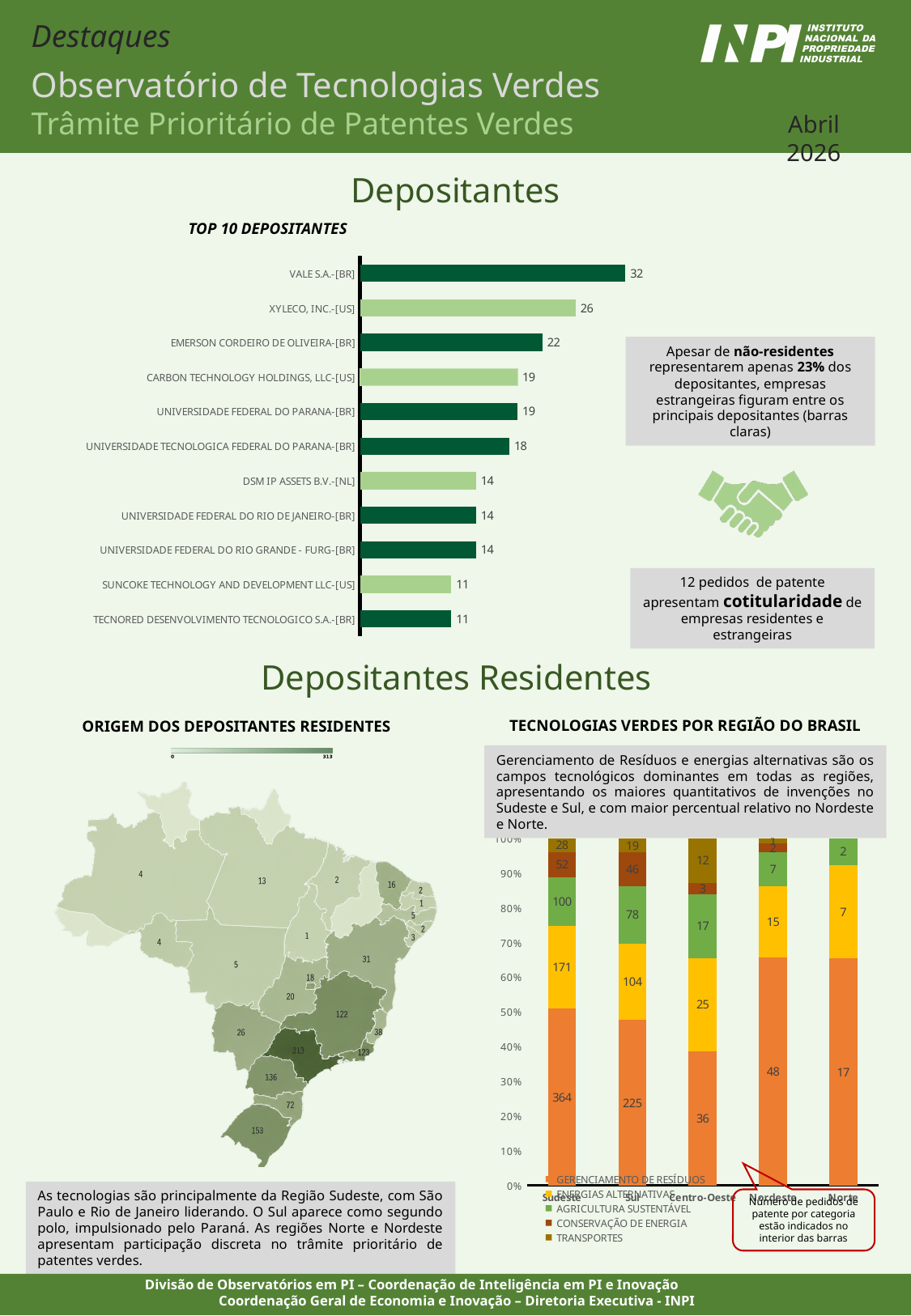
In the TOP 10 DEPOSITANTES chart, how many patent applications does VALE S.A.-[BR] have? 32 In the TOP 10 DEPOSITANTES chart, what is the difference between VALE S.A.-[BR] and EMERSON CORDEIRO DE OLIVEIRA-[BR]? 10 In the TOP 10 DEPOSITANTES chart, which is larger: UNIVERSIDADE TECNOLOGICA FEDERAL DO PARANA-[BR] or DSM IP ASSETS B.V.-[NL]? UNIVERSIDADE TECNOLOGICA FEDERAL DO PARANA-[BR] In the TECNOLOGIAS VERDES POR REGIÃO DO BRASIL chart, what is the total number of patent applications for Sudeste? 715 In the TECNOLOGIAS VERDES POR REGIÃO DO BRASIL chart, what is the value for ENERGIAS ALTERNATIVAS in Sul? 104 In the TECNOLOGIAS VERDES POR REGIÃO DO BRASIL chart, what is the value for GERENCIAMENTO DE RESÍDUOS in Sudeste? 364 In the TECNOLOGIAS VERDES POR REGIÃO DO BRASIL chart, what is the difference between GERENCIAMENTO DE RESÍDUOS in Sudeste and in Sul? 139 In the TOP 10 DEPOSITANTES chart, which depositor has the highest value? VALE S.A.-[BR] How many depositors are listed in the TOP 10 DEPOSITANTES chart? 11 What type of chart is the TOP 10 DEPOSITANTES chart? Bar chart How many series does the legend of the TECNOLOGIAS VERDES POR REGIÃO DO BRASIL chart list? 5 In the TOP 10 DEPOSITANTES chart, what is the value for XYLECO, INC.-[US]? 26